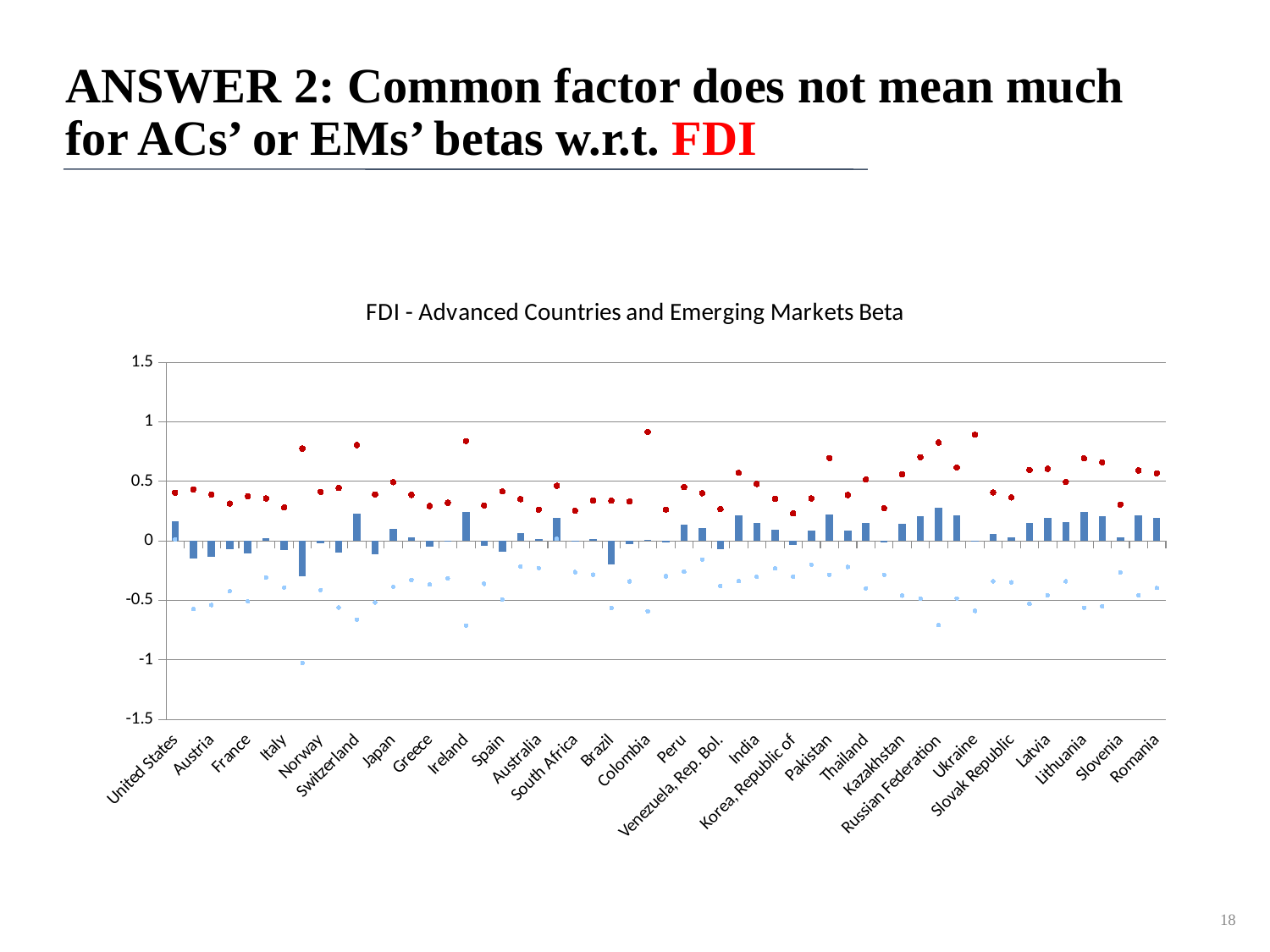
Is the red dot for Ukraine greater or less than 0.5? greater What is the highest value shown on the vertical axis? 1.5 Is the bar for Brazil greater or less than 0? less Is the bar for Switzerland greater or less than 0? greater Which is larger, the bar for Switzerland or the bar for Norway? Switzerland What is the title of the chart? FDI - Advanced Countries and Emerging Markets Beta What kind of chart is shown on the slide? bar chart Which is larger, the red dot for Colombia or the red dot for Greece? Colombia